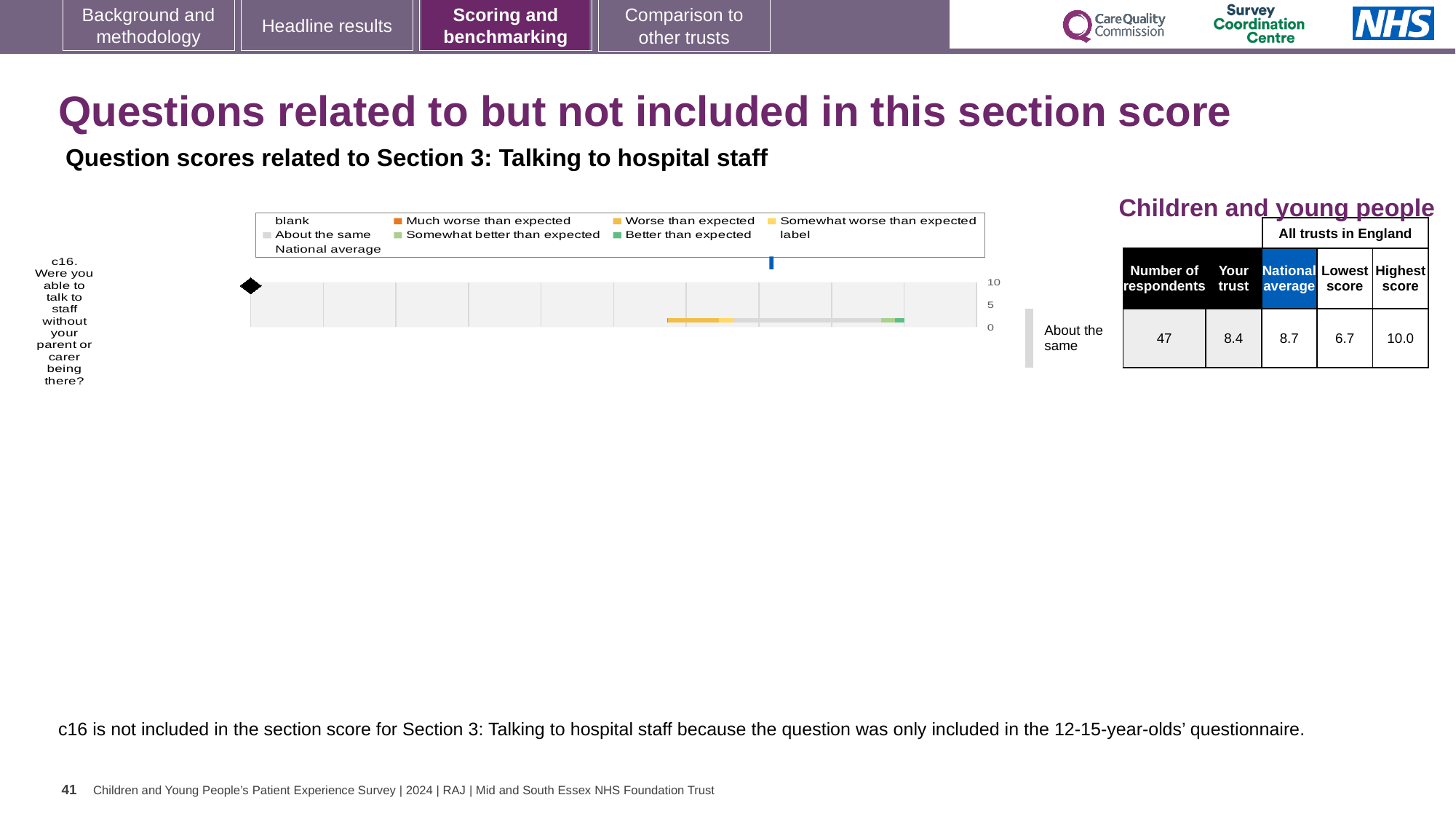
How many entries does the chart legend list? 9 Which is larger for c16, the 'Your trust' score or the national average? National average What kind of chart is used to show the c16 question score? bar chart In the table, what is the highest score among all trusts in England for c16? 10.0 What is the question code of the item plotted in the chart? c16 In the table, what is the 'Your trust' score for c16? 8.4 Which rating category is shown next to the c16 bar? About the same How many questions are plotted in the chart? 1 In the table, how many respondents answered c16? 47 In the table, what is the lowest score among all trusts in England for c16? 6.7 In the table, what is the national average score for c16? 8.7 What is the difference between the highest score and the lowest score for c16 in the table? 3.3